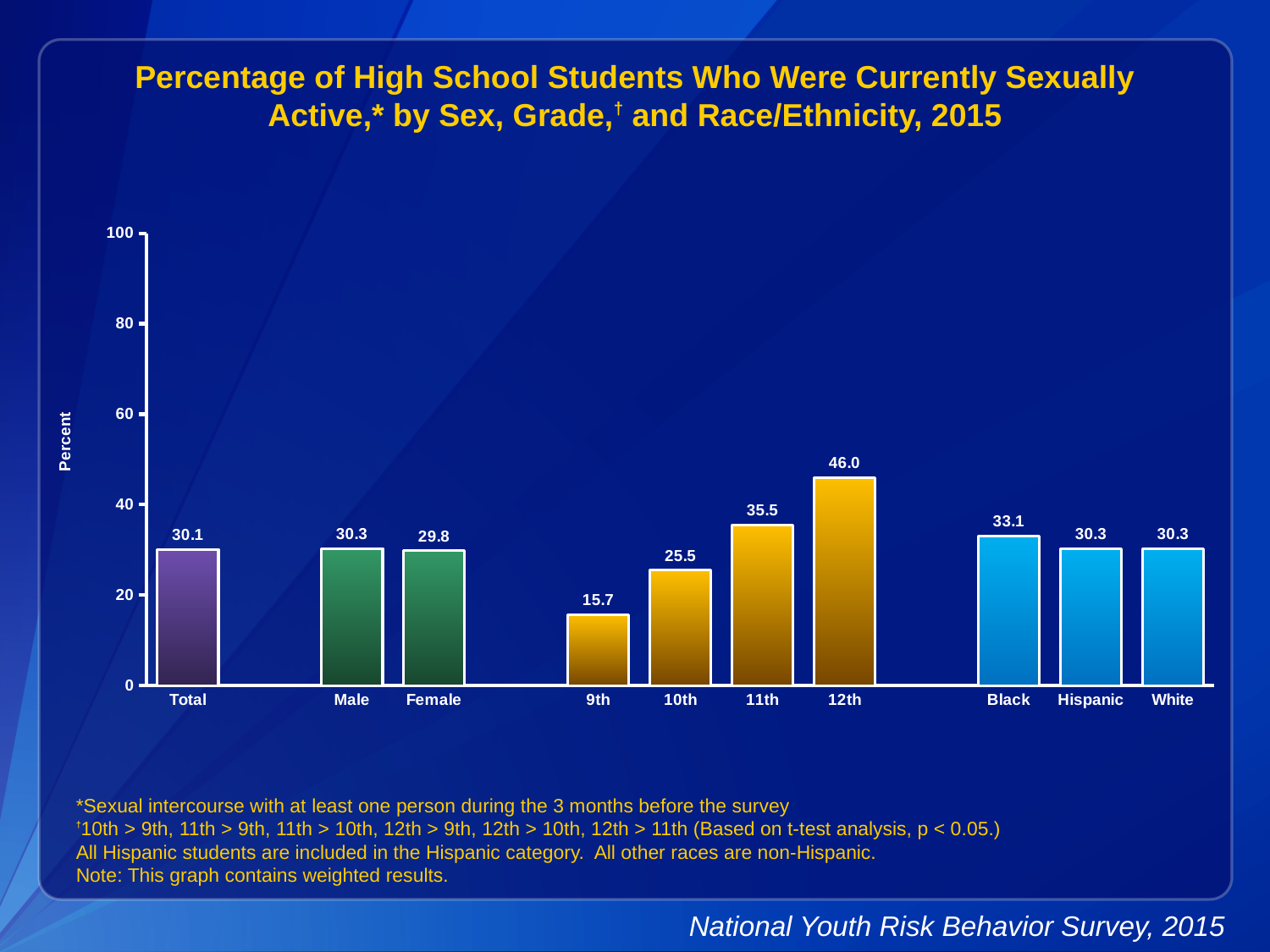
Do the values rise or fall from 9th grade to 12th grade? rise What is the difference between the values for Male and Female? 0.5 What is the value for 12th grade students? 46.0 Which is larger, the value for 11th grade or the value for Black students? 11th What is the value for Black students? 33.1 What is the difference between the values for 12th and 9th grade? 30.3 What kind of chart is shown on the slide? bar chart Which category has the lowest value? 9th How many categories are shown on the x axis? 10 Is the value for 10th grade greater or less than 20? greater What is the value for Total? 30.1 Which category has the highest value? 12th